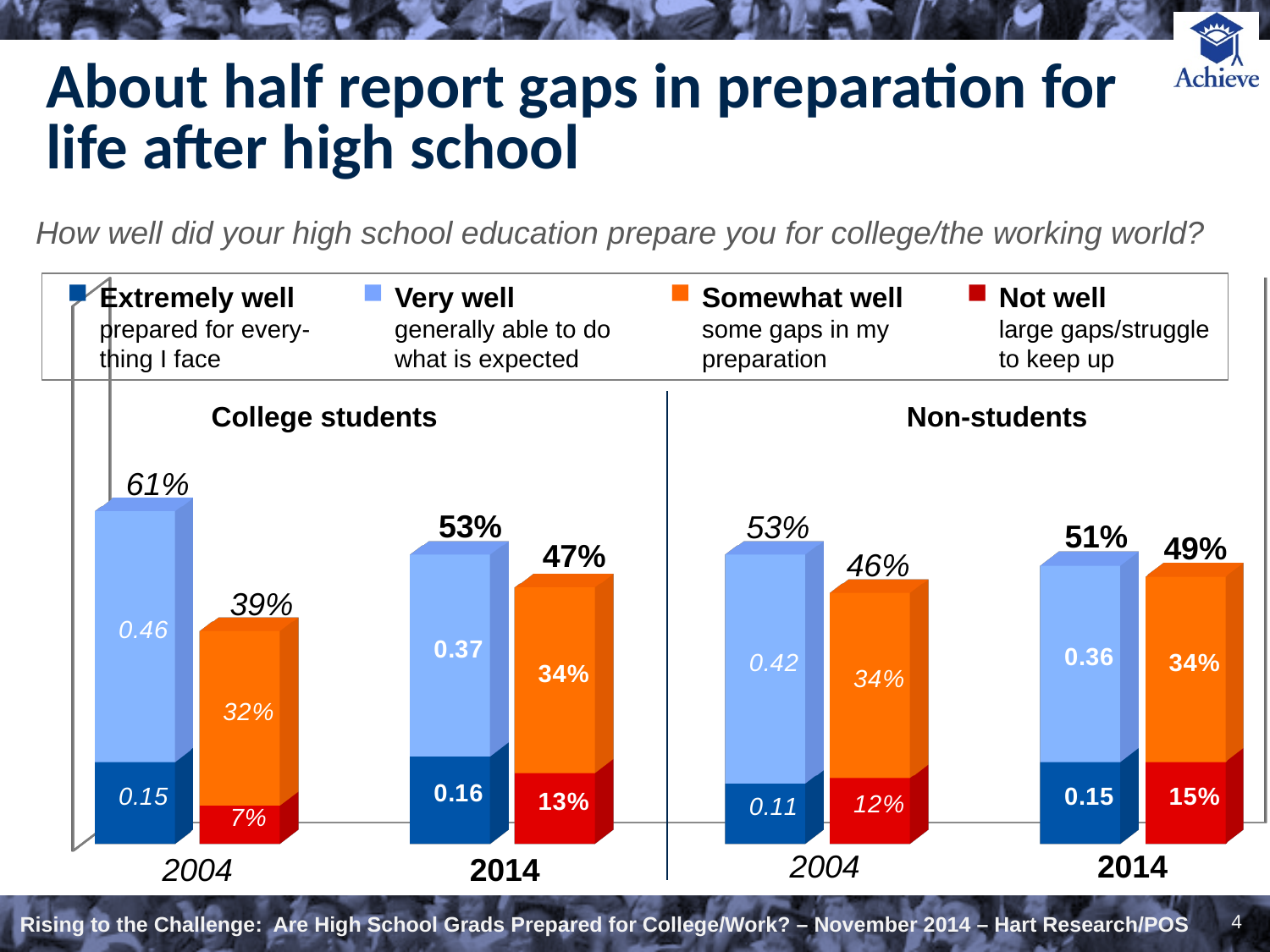
Which group and year has the lowest Not well value? College students, 2004 (7%) For College students in 2004, what is the total shown above the blue stacked bar (Extremely well plus Very well)? 61% For Non-students in 2014, what value is printed for the Not well segment? 15% How many series does the legend list? 4 What is the total shown above the orange/red stacked bar (Somewhat well plus Not well) for Non-students in 2014? 49% For College students in 2004, what value is printed for the Somewhat well segment? 32% Is the Not well value for College students larger in 2004 or in 2014? 2014 By how many percentage points did the combined Somewhat well plus Not well total for College students change from 2004 (39%) to 2014 (47%)? 8 percentage points For College students in 2014, what value is printed for the Very well segment? 0.37 For Non-students in 2004, what value is printed for the Extremely well segment? 0.11 What kind of chart is shown on the slide? Stacked bar chart Which group and year has the highest combined Extremely well plus Very well total? College students, 2004 (61%)